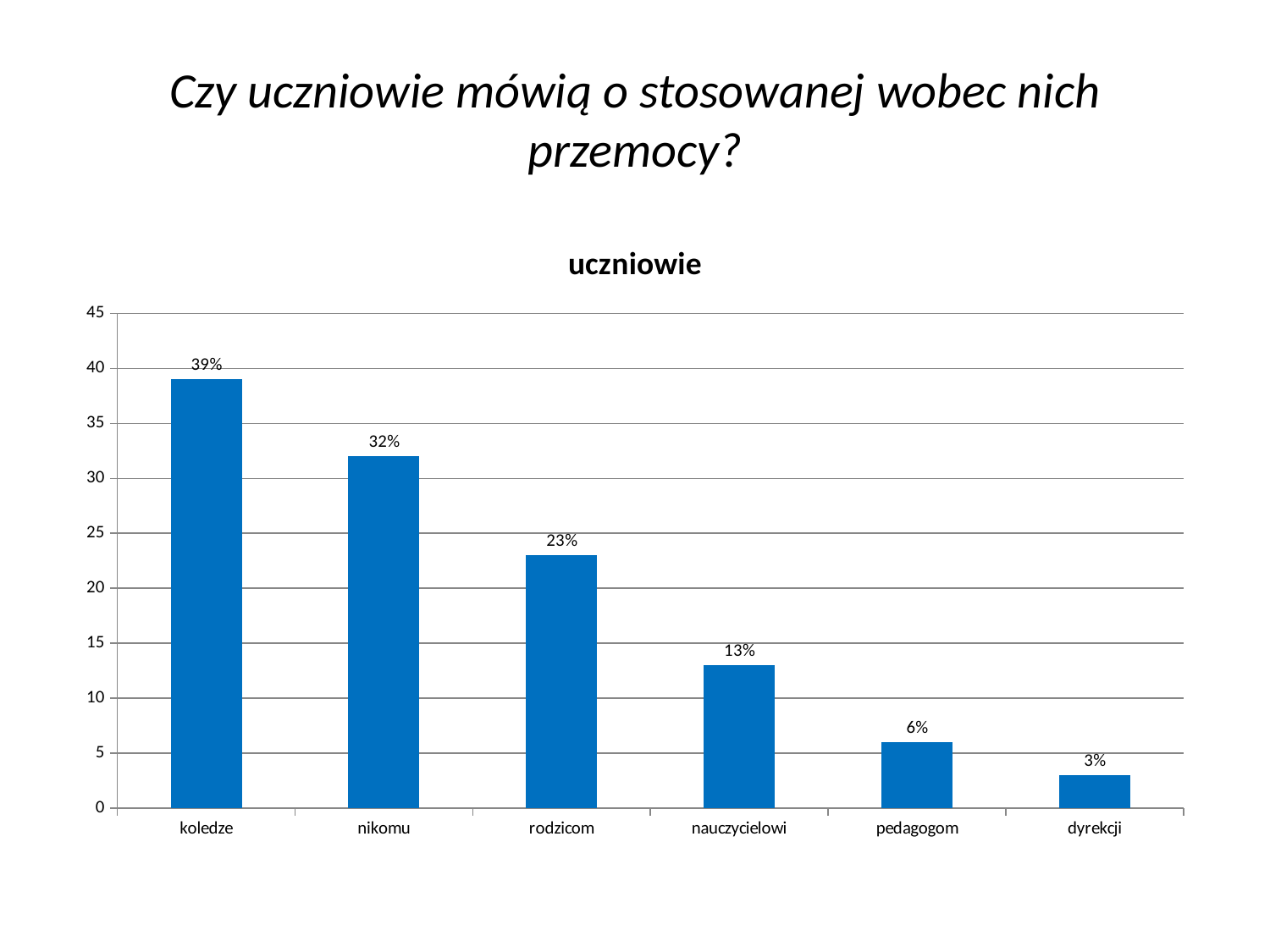
Which is larger, the value for nikomu or the value for rodzicom? nikomu What is the difference between the values for nauczycielowi and dyrekcji? 10% What is the difference between the values for koledze and nikomu? 7% What is the value for rodzicom? 23% Do the values rise or fall from left to right along the x axis? fall What is the value for pedagogom? 6% Is the value for nauczycielowi greater or less than 15? less What kind of chart is shown on the slide? bar chart Which category has the highest value? koledze Which category has the lowest value? dyrekcji What is the value for koledze? 39% How many categories are shown on the x axis? 6